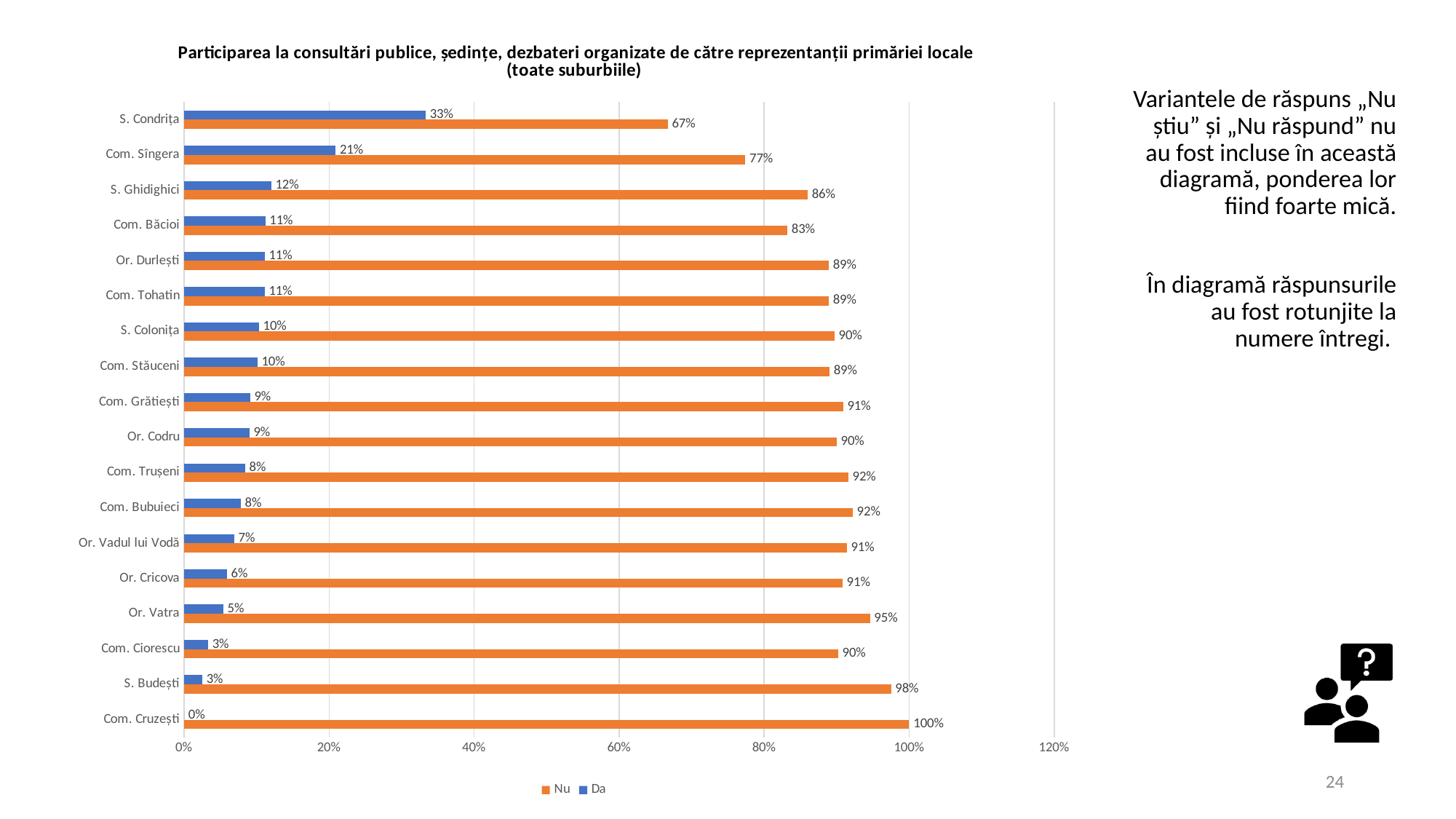
Which is larger: the "Da" value for Com. Sîngera or the "Da" value for S. Ghidighici? Com. Sîngera What is the difference between the "Nu" and "Da" values for S. Condrița? 34% How many series does the legend list? 2 Which category has the lowest "Da" value? Com. Cruzești Which category has the highest "Nu" value? Com. Cruzești What is the "Nu" value for Com. Sîngera? 77% Which colour represents the "Nu" series? Orange Which category has the highest "Da" value? S. Condrița What kind of chart is shown on the slide? Bar chart How many categories (localities) are shown on the chart? 18 What is the "Nu" value for Or. Vatra? 95% What is the "Da" value for S. Condrița? 33%